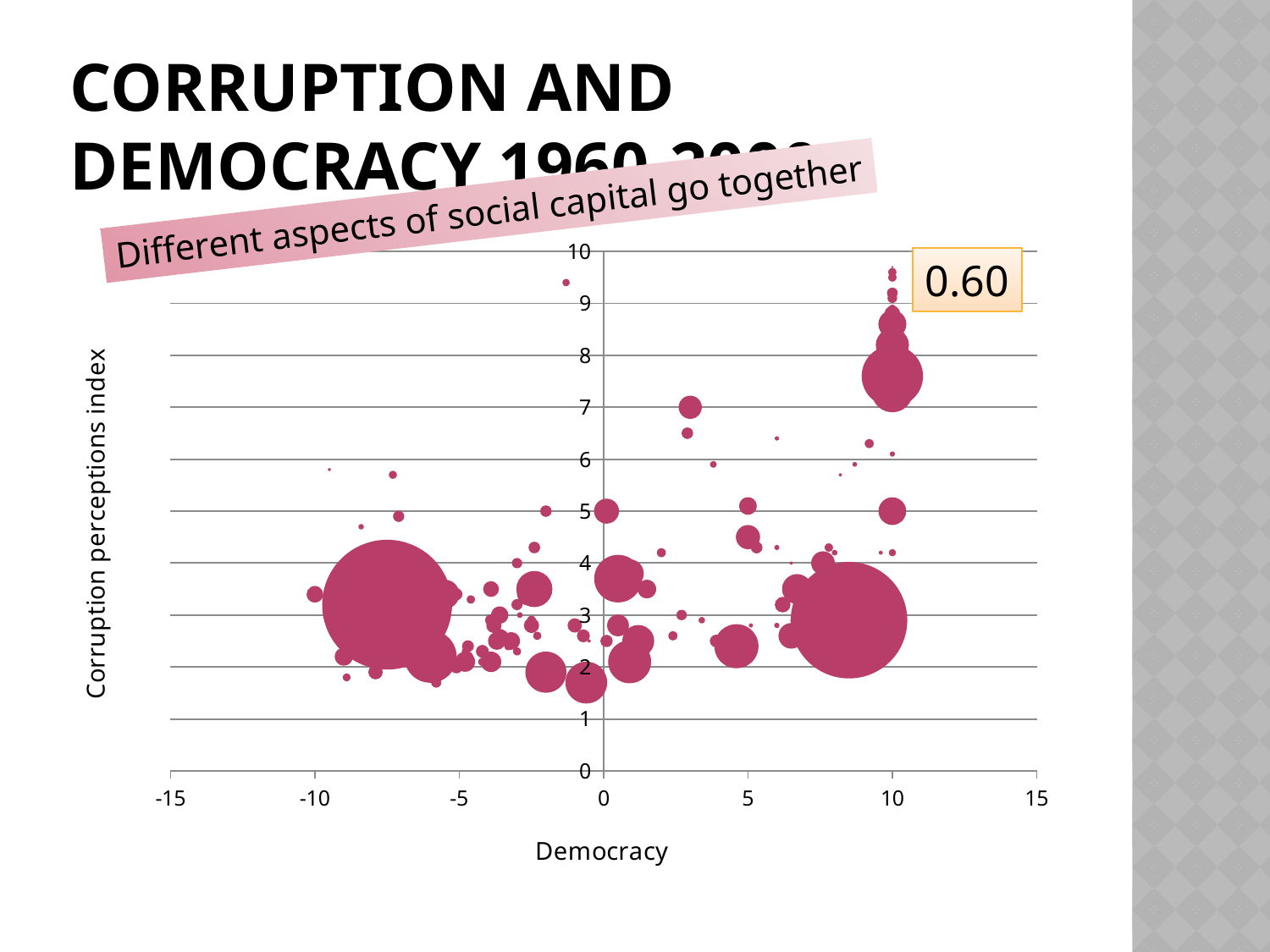
Is the corruption perceptions index of the highest bubble on the chart greater or less than 9? greater Is the corruption perceptions index of the lowest bubble on the chart greater or less than 2? less What is the lowest value shown on the horizontal axis of the chart? -15 What is the title of the horizontal axis of the chart? Democracy What is the highest value shown on the vertical axis of the chart? 10 What is the title of the vertical axis of the chart? Corruption perceptions index What kind of chart is shown on the slide? bubble chart What number is printed in the box in the upper right of the chart? 0.60 Do the corruption perceptions index values generally rise or fall as democracy increases along the x axis? rise